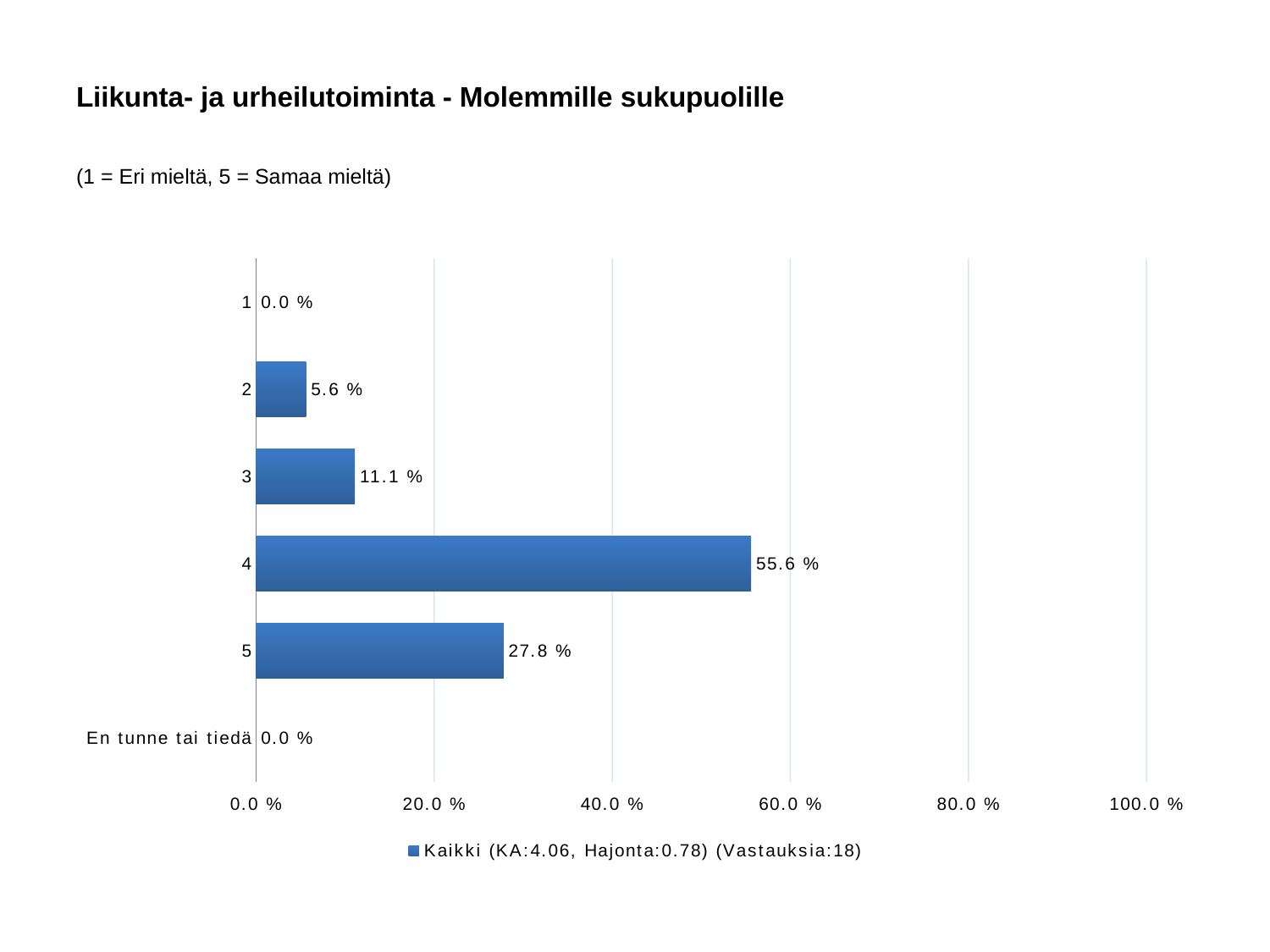
What kind of chart is shown on the slide? bar chart How many series does the legend list? 1 Which is larger, the value for category 3 or the value for category 2? 3 Which category has the highest value? 4 What is the value for category 4? 55.6 % What is the value for category 2? 5.6 % What is the difference between the values for category 4 and category 5? 27.8 % What is the title of the slide? Liikunta- ja urheilutoiminta - Molemmille sukupuolille What is the value for category 5? 27.8 % How many categories are shown on the chart? 6 Is the value for category 4 greater or less than 40.0 %? greater What is the value for 'En tunne tai tiedä'? 0.0 %